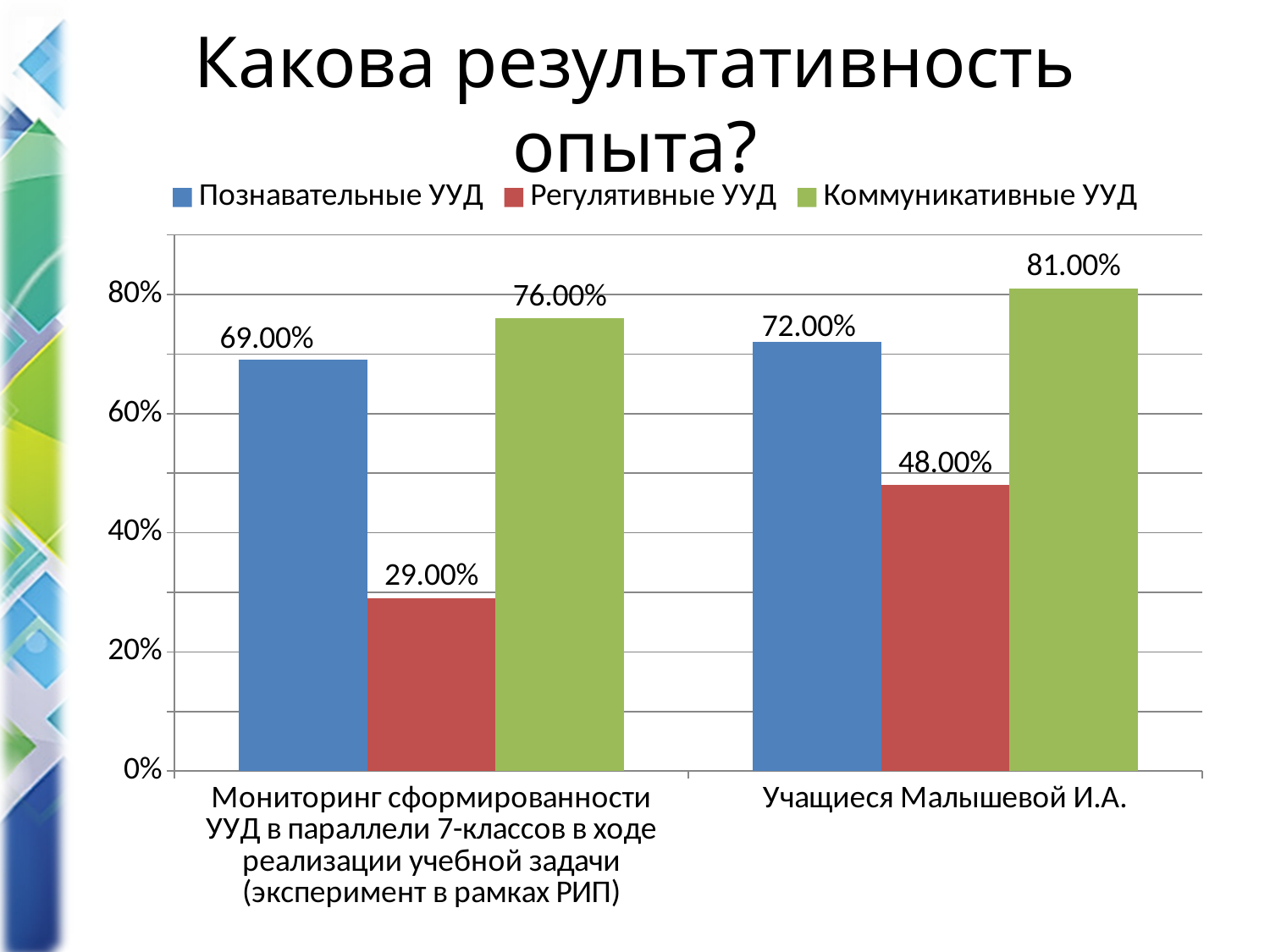
Is the value of Коммуникативные УУД for Учащиеся Малышевой И.А. greater or less than 80%? greater What colour represents Регулятивные УУД in the chart? red What is the value of Познавательные УУД for Учащиеся Малышевой И.А.? 72.00% Which series has the highest value for Учащиеся Малышевой И.А.? Коммуникативные УУД How many series does the legend list? 3 Which is larger: Познавательные УУД for Учащиеся Малышевой И.А. or Познавательные УУД for the Мониторинг category? Учащиеся Малышевой И.А. Which series has the lowest value for the category 'Мониторинг сформированности УУД в параллели 7-классов...'? Регулятивные УУД What is the difference between the Регулятивные УУД values for Учащиеся Малышевой И.А. and for the Мониторинг category? 19.00% What is the value of Регулятивные УУД for the category 'Мониторинг сформированности УУД в параллели 7-классов в ходе реализации учебной задачи (эксперимент в рамках РИП)'? 29.00% What kind of chart is shown on the slide? bar chart How many categories are shown on the x axis? 2 What is the value of Коммуникативные УУД for Учащиеся Малышевой И.А.? 81.00%